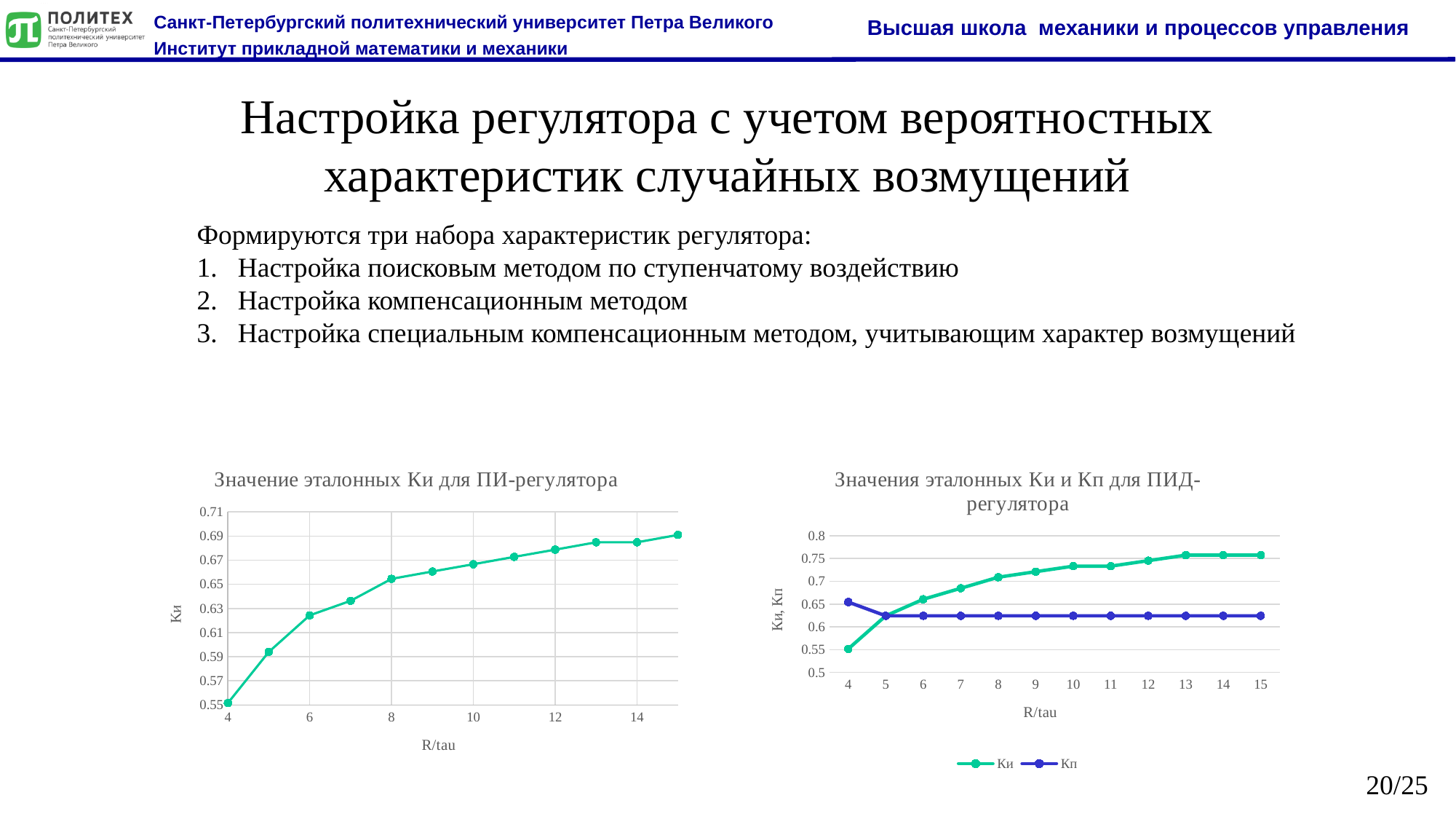
In the right chart, 'Значения эталонных Ки и Кп для ПИД-регулятора', which series has the larger value at R/tau = 10, Ки or Кп? Ки In the left chart, 'Значение эталонных Ки для ПИ-регулятора', at which R/tau value is Ки lowest? 4 In the right chart, 'Значения эталонных Ки и Кп для ПИД-регулятора', what are the two series named in the legend? Ки and Кп What kind of chart is the left chart, 'Значение эталонных Ки для ПИ-регулятора'? line chart What kind of chart is the right chart, 'Значения эталонных Ки и Кп для ПИД-регулятора'? line chart How many series does the legend of the right chart, 'Значения эталонных Ки и Кп для ПИД-регулятора', list? 2 In the left chart, 'Значение эталонных Ки для ПИ-регулятора', at which R/tau value is Ки highest? 15 How many data points are plotted in the right chart, 'Значения эталонных Ки и Кп для ПИД-регулятора', for the Ки series? 12 In the left chart, 'Значение эталонных Ки для ПИ-регулятора', does Ки rise or fall as R/tau increases? rise In the left chart, 'Значение эталонных Ки для ПИ-регулятора', is the value of Ки at R/tau = 6 greater or less than 0.61? greater In the right chart, 'Значения эталонных Ки и Кп для ПИД-регулятора', is the Ки value at R/tau = 4 greater or less than 0.6? less What is the label of the x axis in the left chart, 'Значение эталонных Ки для ПИ-регулятора'? R/tau